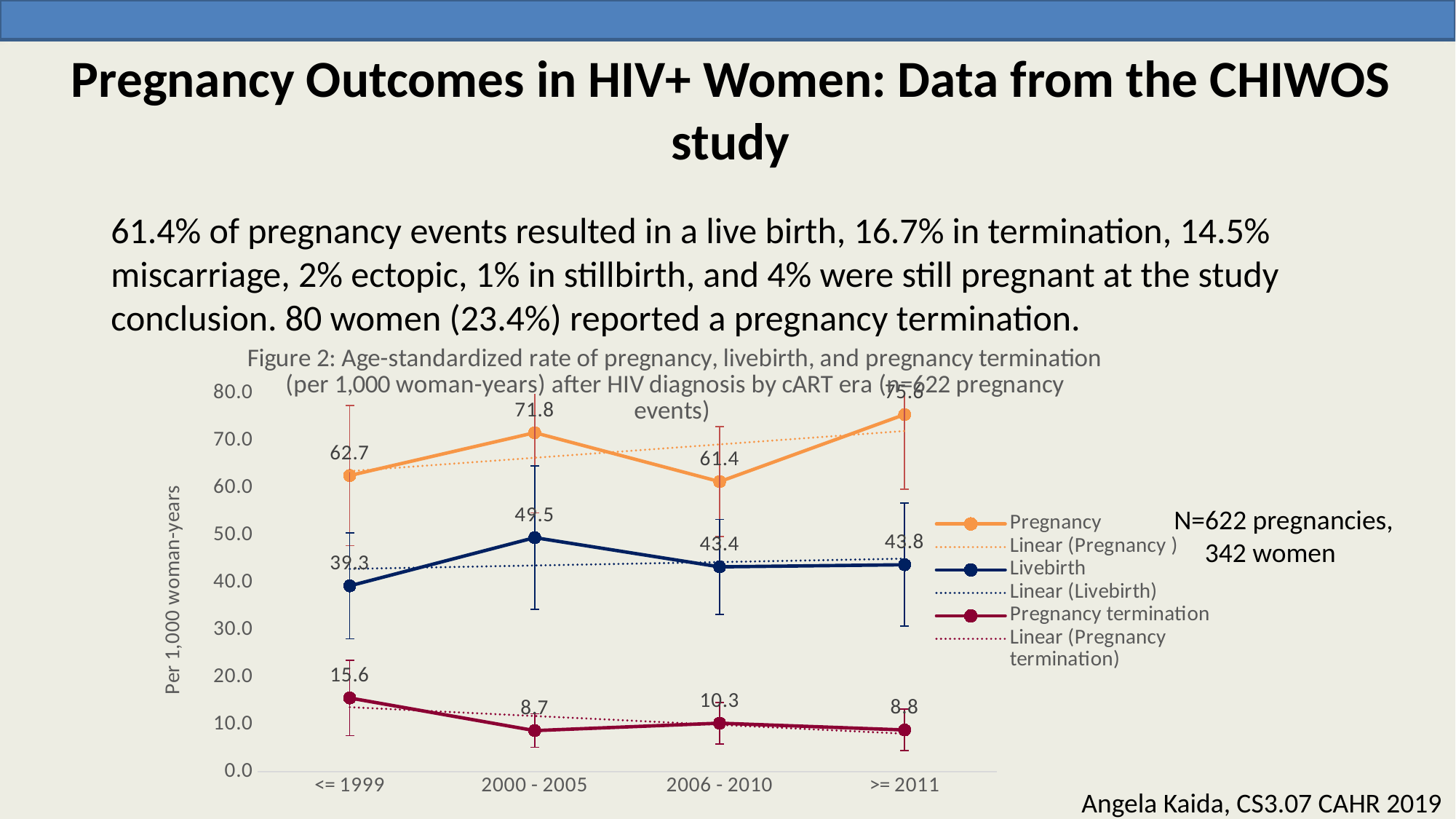
In which cART era is the pregnancy termination rate highest? <= 1999 How many cART era categories are shown on the x axis? 4 How many entries does the chart legend list? 6 Is the pregnancy rate for the >= 2011 era greater or less than 70.0? greater What type of chart is Figure 2? line chart In which cART era is the pregnancy rate lowest? 2006 - 2010 What is the pregnancy termination rate for the 2006 - 2010 era? 10.3 What is the livebirth rate for the <= 1999 era? 39.3 What is the age-standardized pregnancy rate for the 2000 - 2005 cART era? 71.8 What is the difference between the livebirth rate in 2000 - 2005 and in <= 1999? 10.2 In which cART era is the livebirth rate highest? 2000 - 2005 Which era has the higher pregnancy rate, 2000 - 2005 or 2006 - 2010? 2000 - 2005